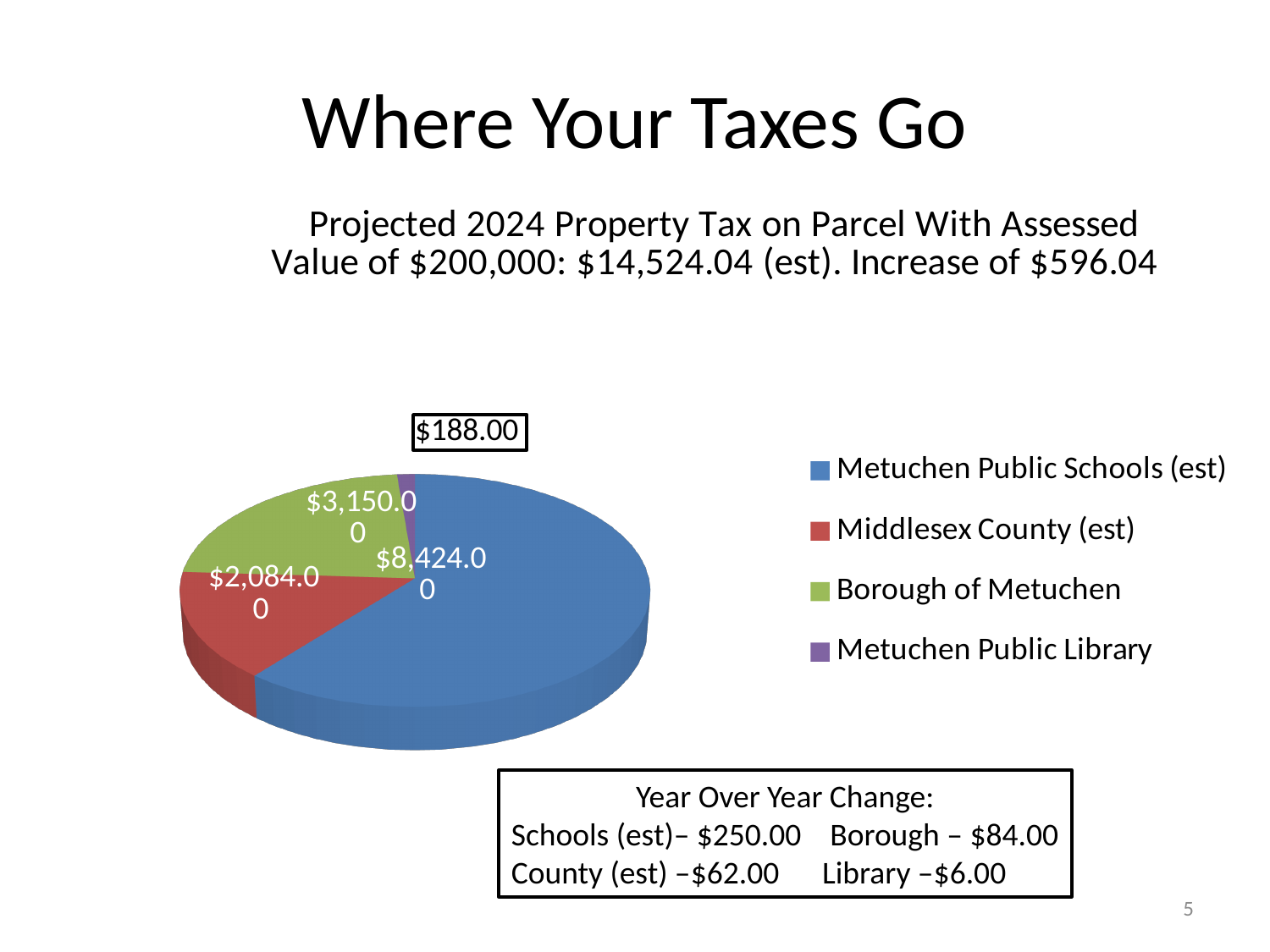
Which category has the smallest slice of the pie chart? Metuchen Public Library What is the difference between the Borough of Metuchen value and the Middlesex County (est) value? $1,066.00 Which colour represents Metuchen Public Library in the legend? Purple What is the value shown for Metuchen Public Schools (est) on the pie chart? $8,424.00 What is the value shown for Borough of Metuchen on the pie chart? $3,150.00 What is the value shown for Middlesex County (est) on the pie chart? $2,084.00 What is the value shown for Metuchen Public Library on the pie chart? $188.00 Which category has the largest slice of the pie chart? Metuchen Public Schools (est) What is the difference between the Metuchen Public Schools (est) value and the Borough of Metuchen value? $5,274.00 What type of chart is shown on the slide? Pie chart Which is larger, the Borough of Metuchen slice or the Middlesex County (est) slice? Borough of Metuchen How many slices does the pie chart have? 4